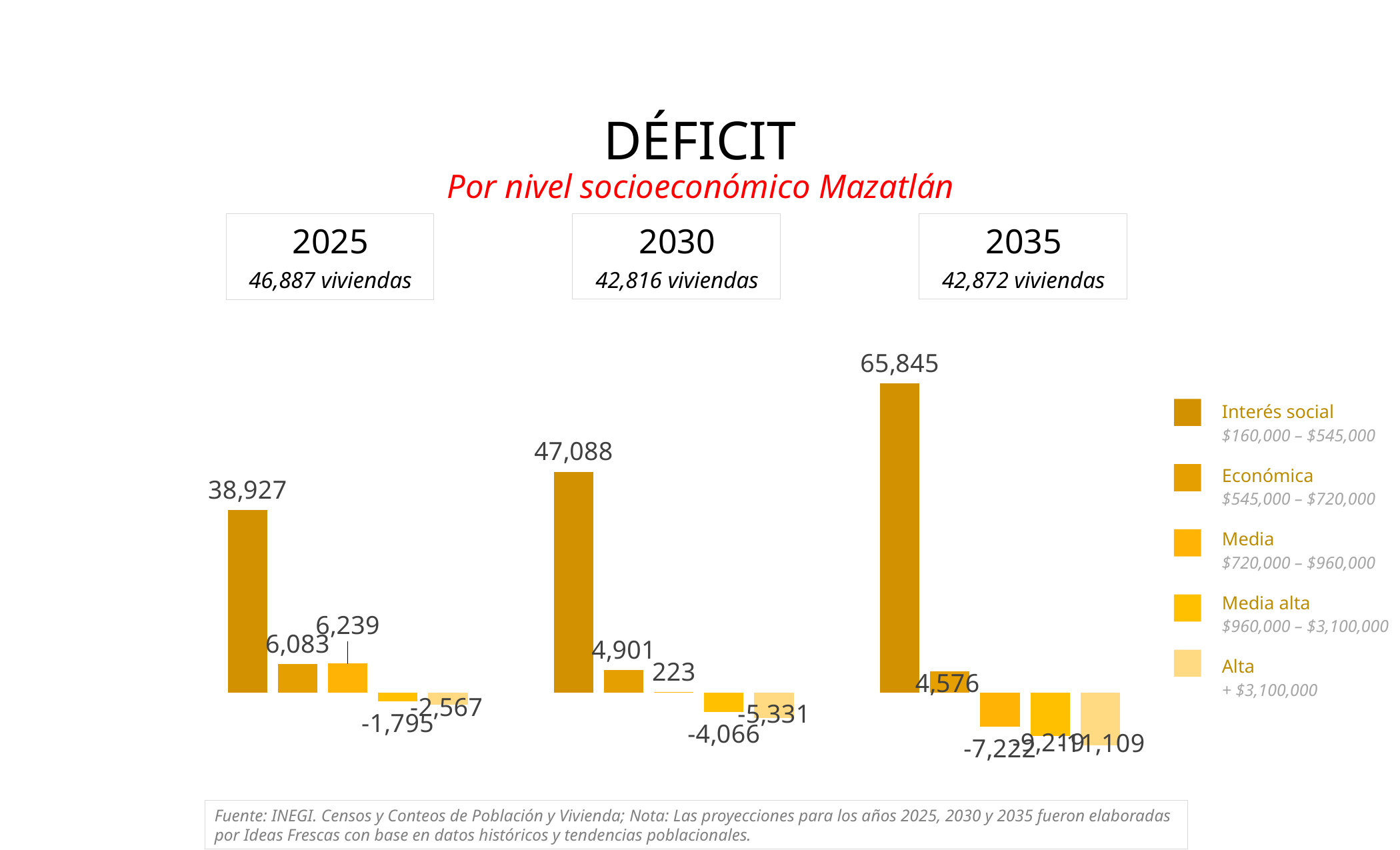
In the 2035 chart, what is the value for Interés social? 65,845 In the 2030 chart, what is the value for Interés social? 47,088 How many series does the legend list? 5 In the 2030 chart, what is the value for Media? 223 In the 2030 chart, what is the value for Alta? -5,331 In the 2025 chart, which is larger, the value for Económica or the value for Media? Media How many bars are plotted in the 2035 chart? 5 What is the difference between the Interés social value in the 2030 chart and the Interés social value in the 2025 chart? 8,161 What kind of chart is used for the 2030 data? Bar chart Across the three charts, which year has the highest value for Interés social? 2035 In the 2025 chart, what is the value for Interés social? 38,927 In the 2025 chart, what is the value for Media alta? -1,795